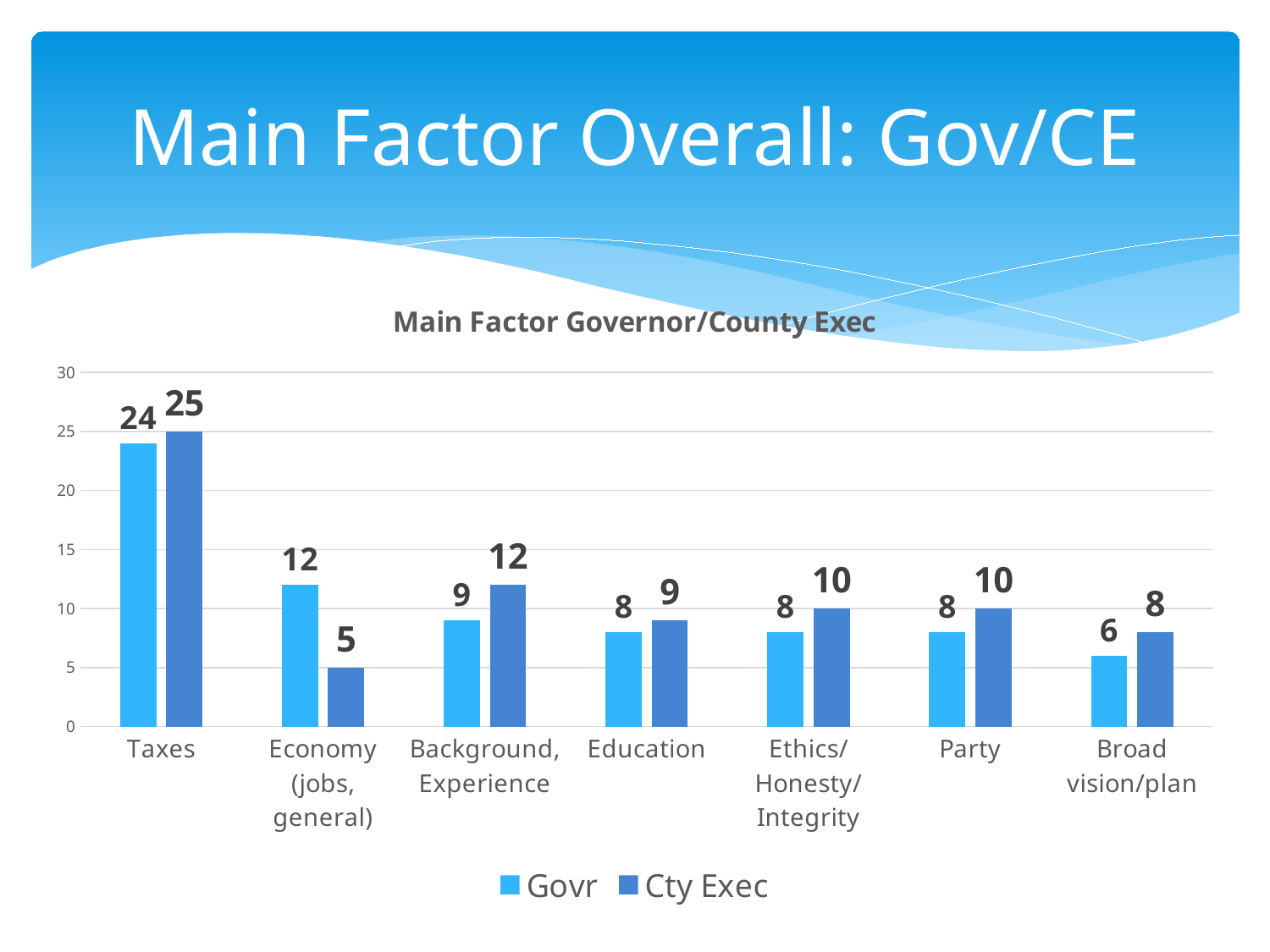
How many series does the legend list? 2 Which category has the lowest Govr value? Broad vision/plan Which is larger for Background, Experience: the Govr value or the Cty Exec value? Cty Exec What is the difference between the Govr and Cty Exec values for Economy (jobs, general)? 7 Which category has the highest Cty Exec value? Taxes What kind of chart is shown on the slide? Bar chart What is the Cty Exec value for Economy (jobs, general)? 5 What is the Govr value for Taxes? 24 What is the title of the chart? Main Factor Governor/County Exec What is the difference between the Cty Exec values for Taxes and Party? 15 What is the Cty Exec value for Broad vision/plan? 8 How many categories are shown on the x axis? 7